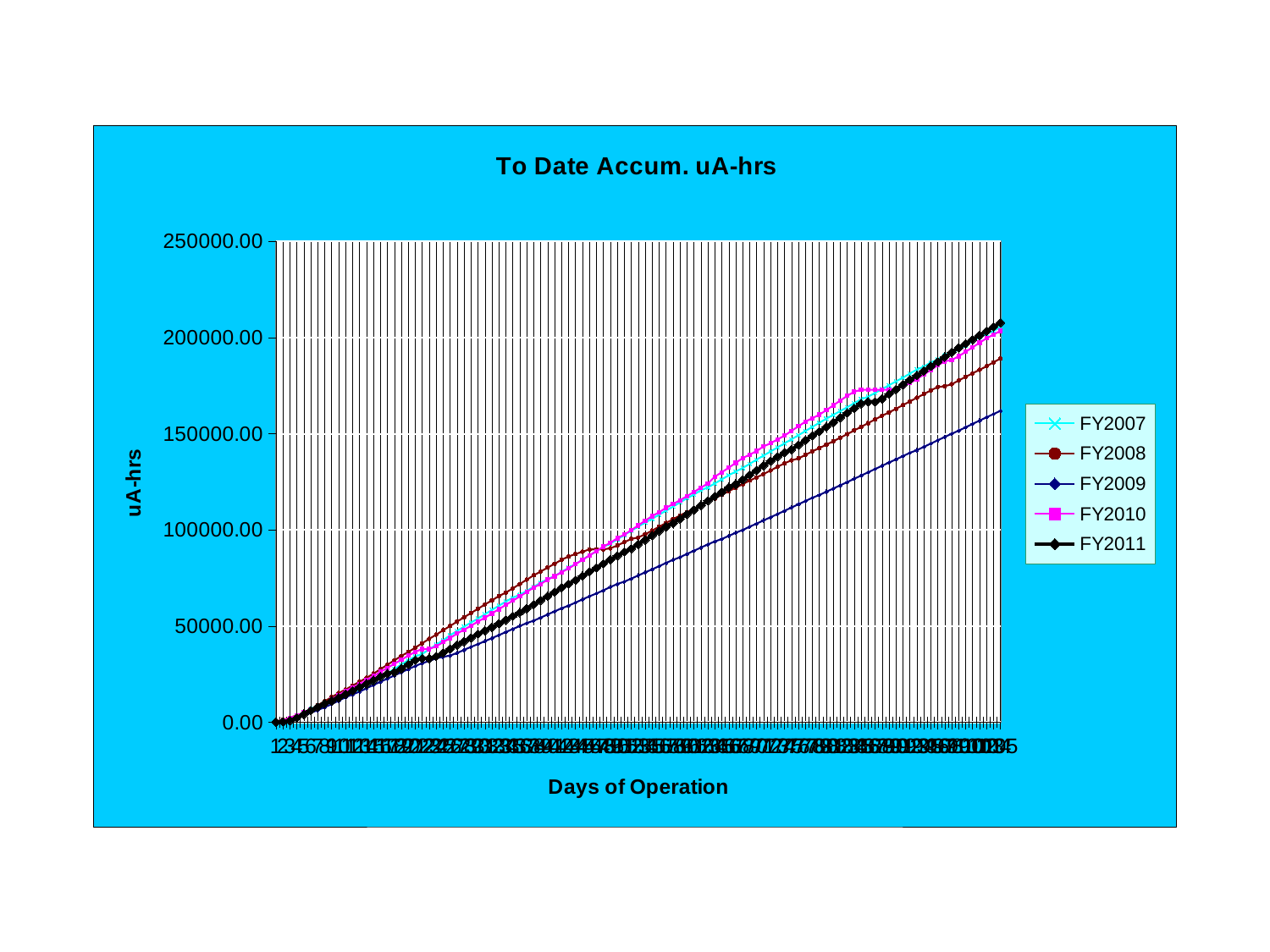
Do the values of the FY2011 series rise or fall as the days of operation increase? rise How many series does the legend list? 5 Is the final value of the FY2011 series greater or less than 200000.00? greater At the final day of operation, which series has the larger value, FY2008 or FY2009? FY2008 What kind of chart is shown on the slide? line chart What is the label on the x axis of the chart? Days of Operation Is the final value of the FY2009 series greater or less than 200000.00? less Is the final value of the FY2008 series greater or less than 150000.00? greater Which series has the lowest accumulated uA-hrs at the final day of operation? FY2009 What is the title of the chart? To Date Accum. uA-hrs At the final day of operation, which series has the larger value, FY2009 or FY2011? FY2011